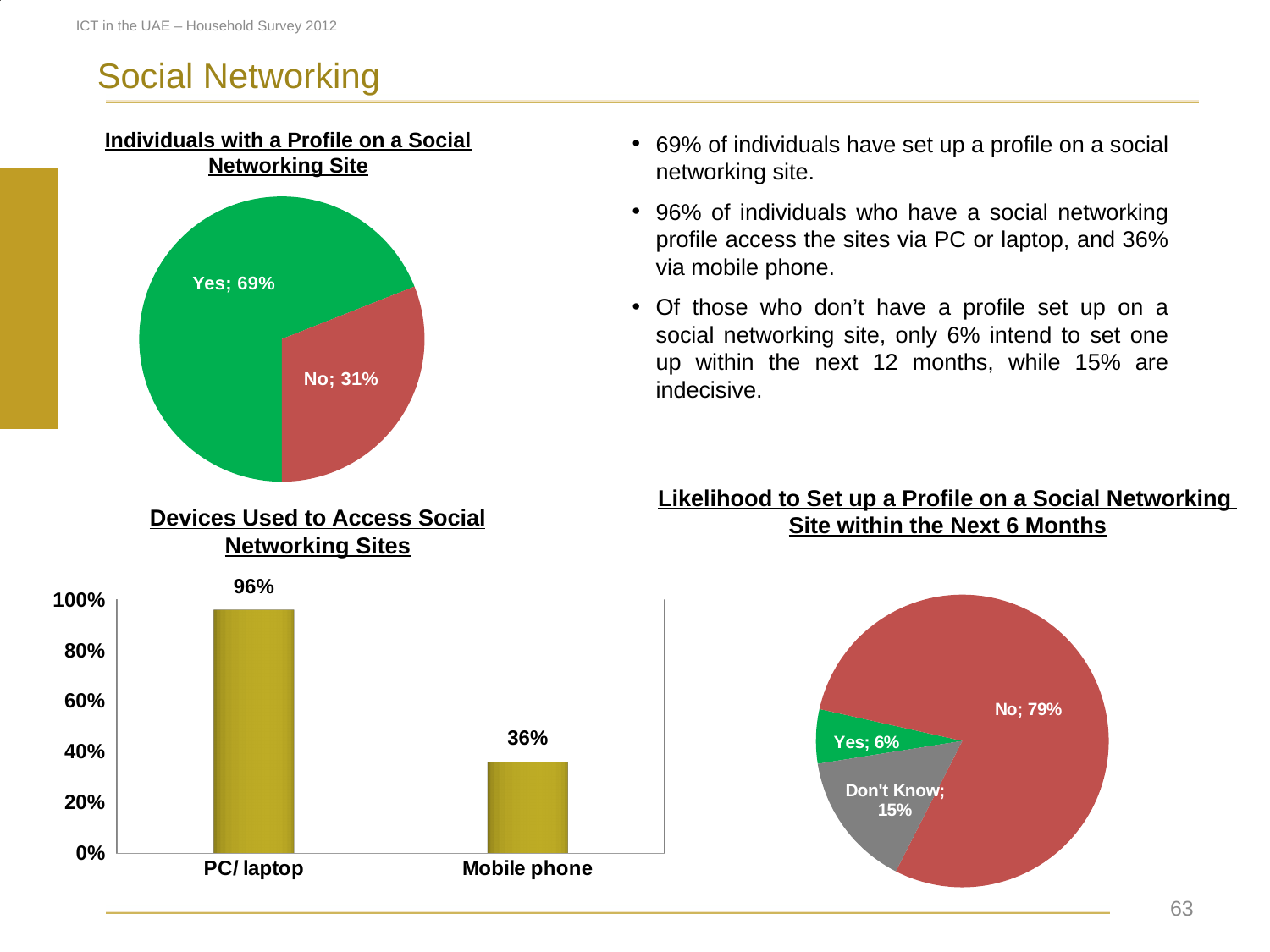
In the 'Devices Used to Access Social Networking Sites' chart, what is the value for PC/ laptop? 96% In the 'Devices Used to Access Social Networking Sites' chart, what is the difference between the PC/ laptop and Mobile phone values? 60% How many categories are shown in the 'Devices Used to Access Social Networking Sites' chart? 2 In the 'Individuals with a Profile on a Social Networking Site' pie chart, what share of individuals answered No? 31% In the 'Devices Used to Access Social Networking Sites' chart, which device has the highest value? PC/ laptop In the 'Likelihood to Set up a Profile on a Social Networking Site within the Next 6 Months' pie chart, how many slices are there? 3 In the 'Individuals with a Profile on a Social Networking Site' pie chart, what is the difference between the Yes and No shares? 38% In the 'Likelihood to Set up a Profile on a Social Networking Site within the Next 6 Months' pie chart, what share answered No? 79% In the 'Devices Used to Access Social Networking Sites' chart, what is the value for Mobile phone? 36% What kind of chart is 'Devices Used to Access Social Networking Sites'? Bar chart In the 'Individuals with a Profile on a Social Networking Site' pie chart, what share of individuals answered Yes? 69% In the 'Likelihood to Set up a Profile on a Social Networking Site within the Next 6 Months' pie chart, which response has the smallest share? Yes